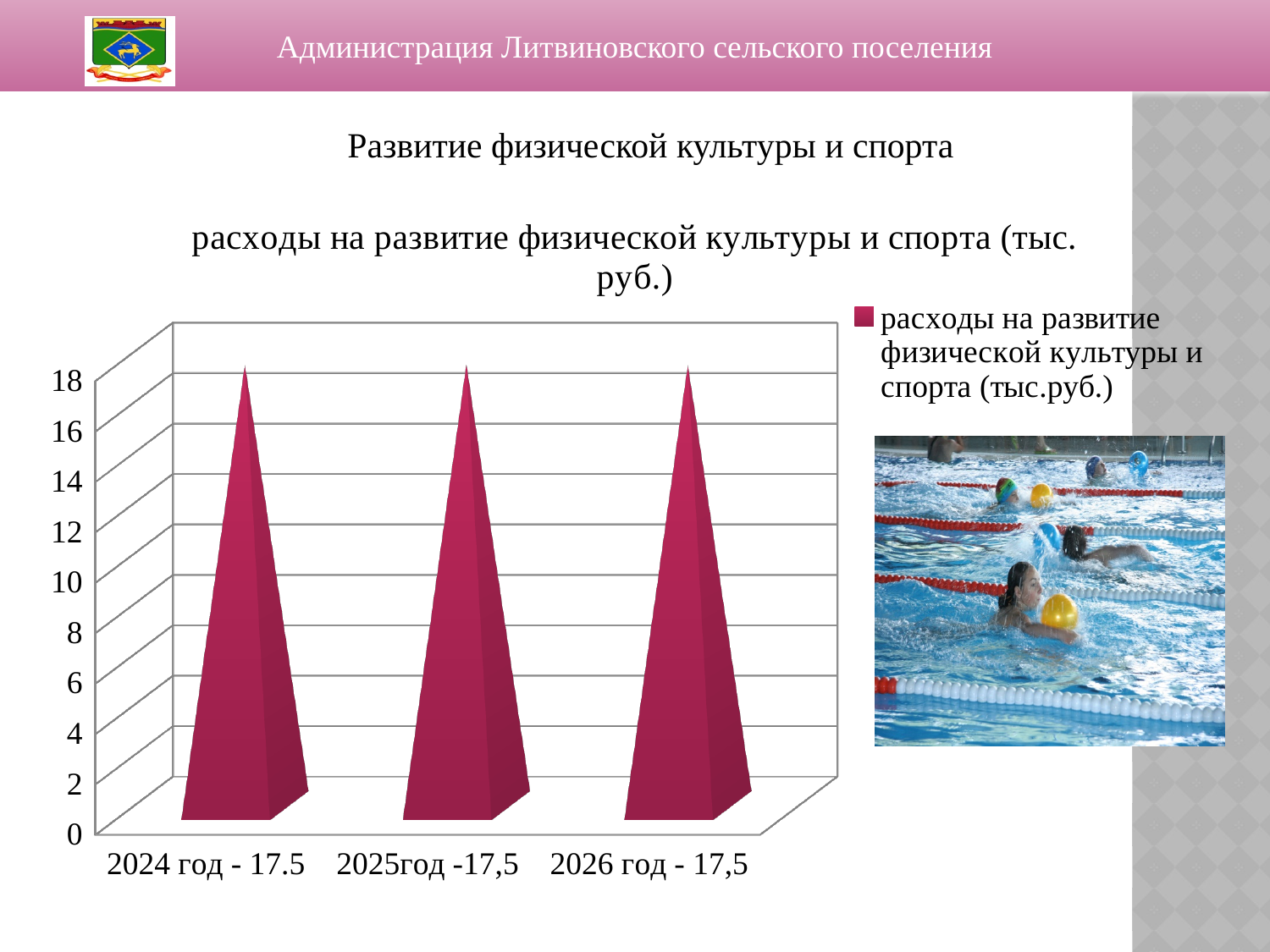
What is the title of the chart? расходы на развитие физической культуры и спорта (тыс. руб.) What value is given in the category label for 2026 год? 17,5 What kind of chart is shown on the slide? bar chart What value is given in the category label for 2024 год? 17.5 What is the legend entry of the chart? расходы на развитие физической культуры и спорта (тыс.руб.) What is the difference between the values for 2025год and 2026 год? 0 Do the values rise, fall or stay the same from 2024 год to 2026 год? stay the same How many series does the chart legend list? 1 How many categories are shown on the x axis of the chart? 3 Is the value for 2024 год greater or less than 16? greater What value is given in the category label for 2025год? 17,5 Is the value for 2026 год greater or less than 10? greater